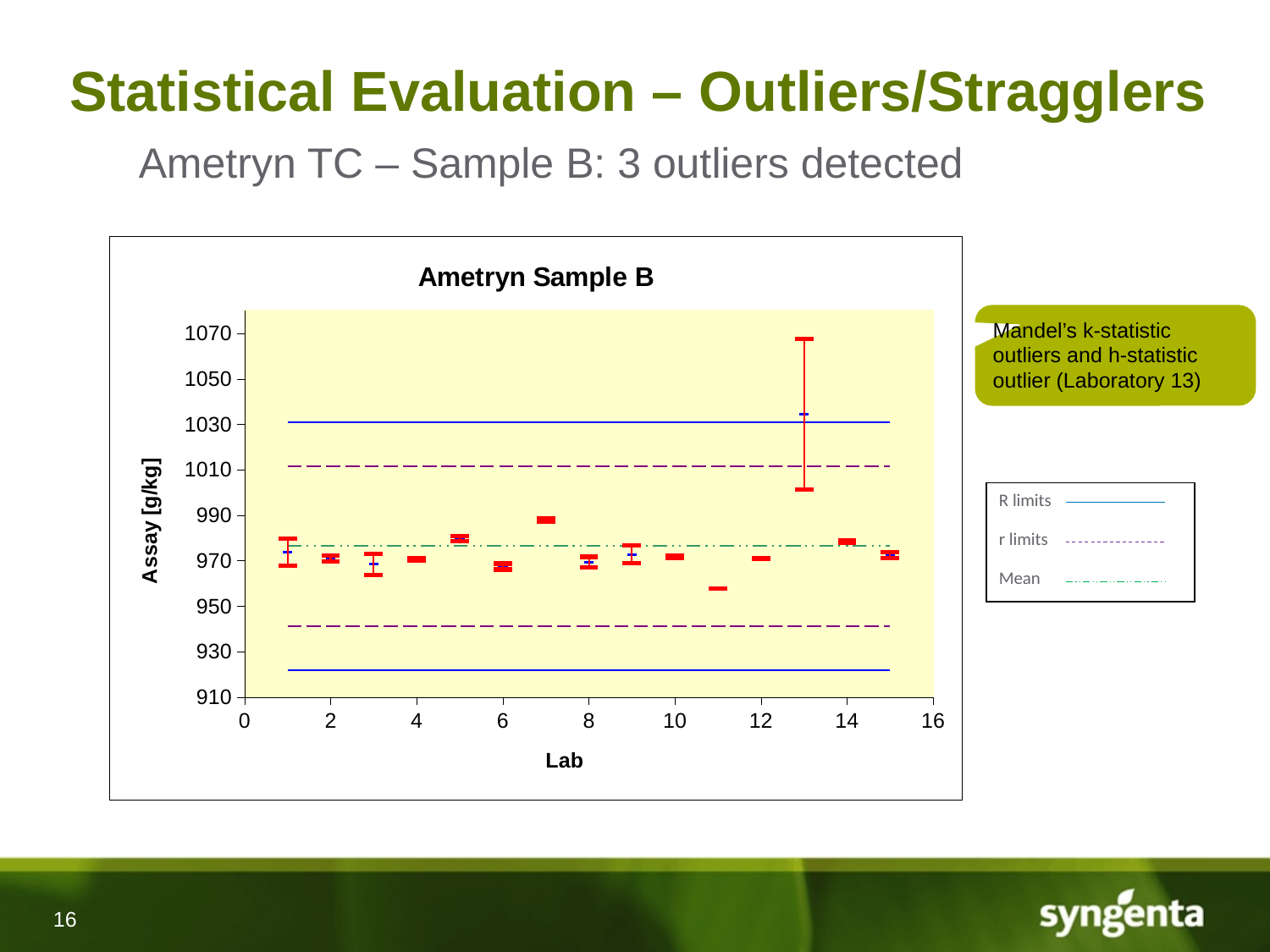
Is the assay value for Lab 11 greater or less than 970? less Which lab has the highest assay value on the chart? Lab 13 How many labs are plotted on the chart? 15 Which lab has the larger assay value, Lab 13 or Lab 5? Lab 13 Is the assay value for Lab 7 greater or less than 970? greater What is the title of the chart? Ametryn Sample B Is the assay value for Lab 13 greater or less than 1010? greater How many entries does the chart legend list? 3 Which lab has the lowest assay value on the chart? Lab 11 Which lab has the larger assay value, Lab 7 or Lab 11? Lab 7 What are the three entries in the chart legend? R limits, r limits, Mean What is the label of the y axis? Assay [g/kg]